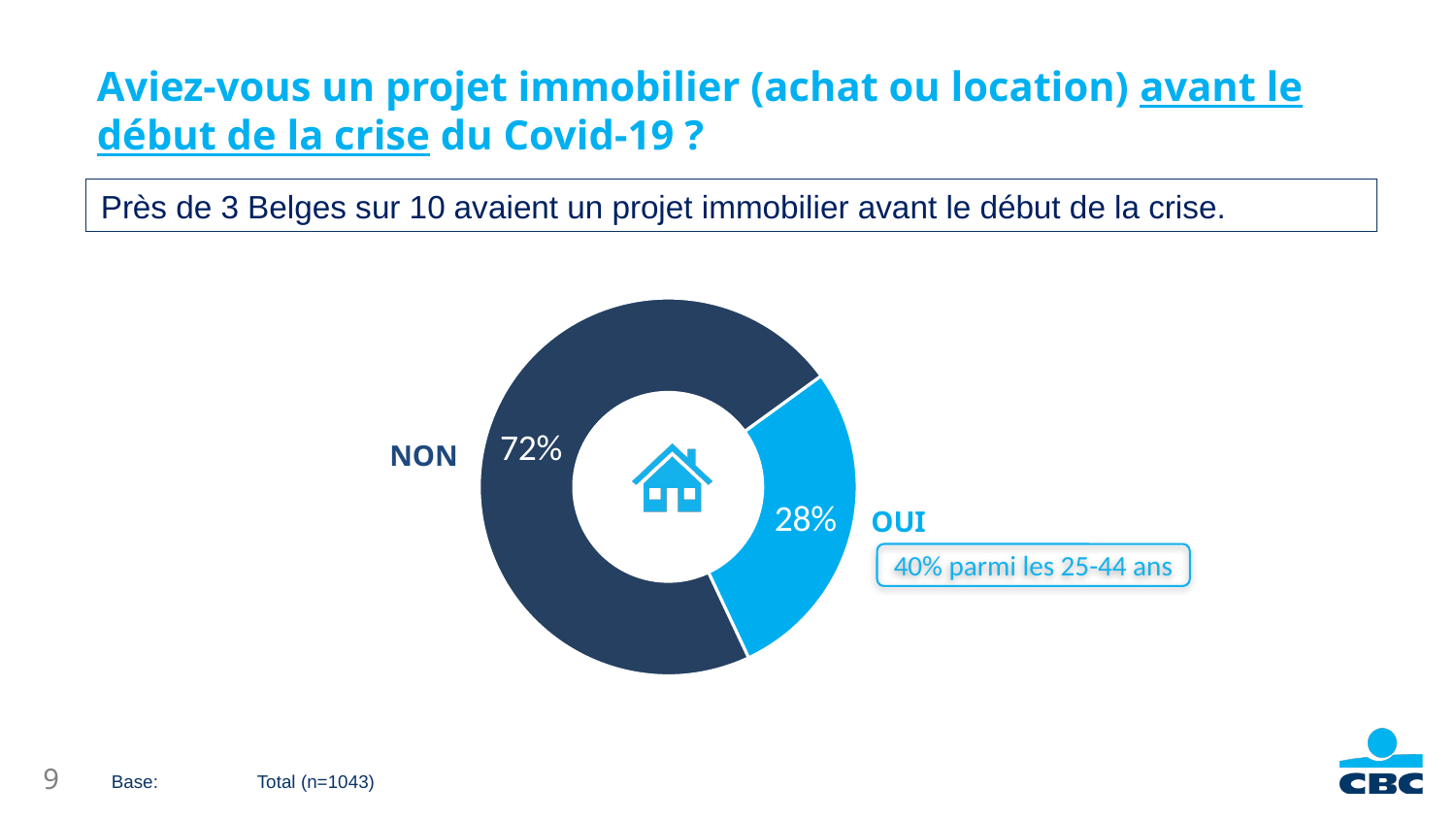
What is the difference in percentage points between NON and OUI? 44 What percentage of respondents answered OUI? 28% How many categories are shown in the chart? 2 Which response has the largest share of the chart? NON Which is larger, the share for OUI or the share for NON? NON What kind of chart is shown on the slide? Pie chart (donut) Which response has the smallest share of the chart? OUI What share of the pie does the OUI slice represent? 28% According to the callout next to OUI, what percentage of 25-44 year olds had a property project? 40% What is the total of the two slices shown in the chart? 100% What percentage of respondents answered NON? 72% What colour is the OUI slice of the chart? Light blue